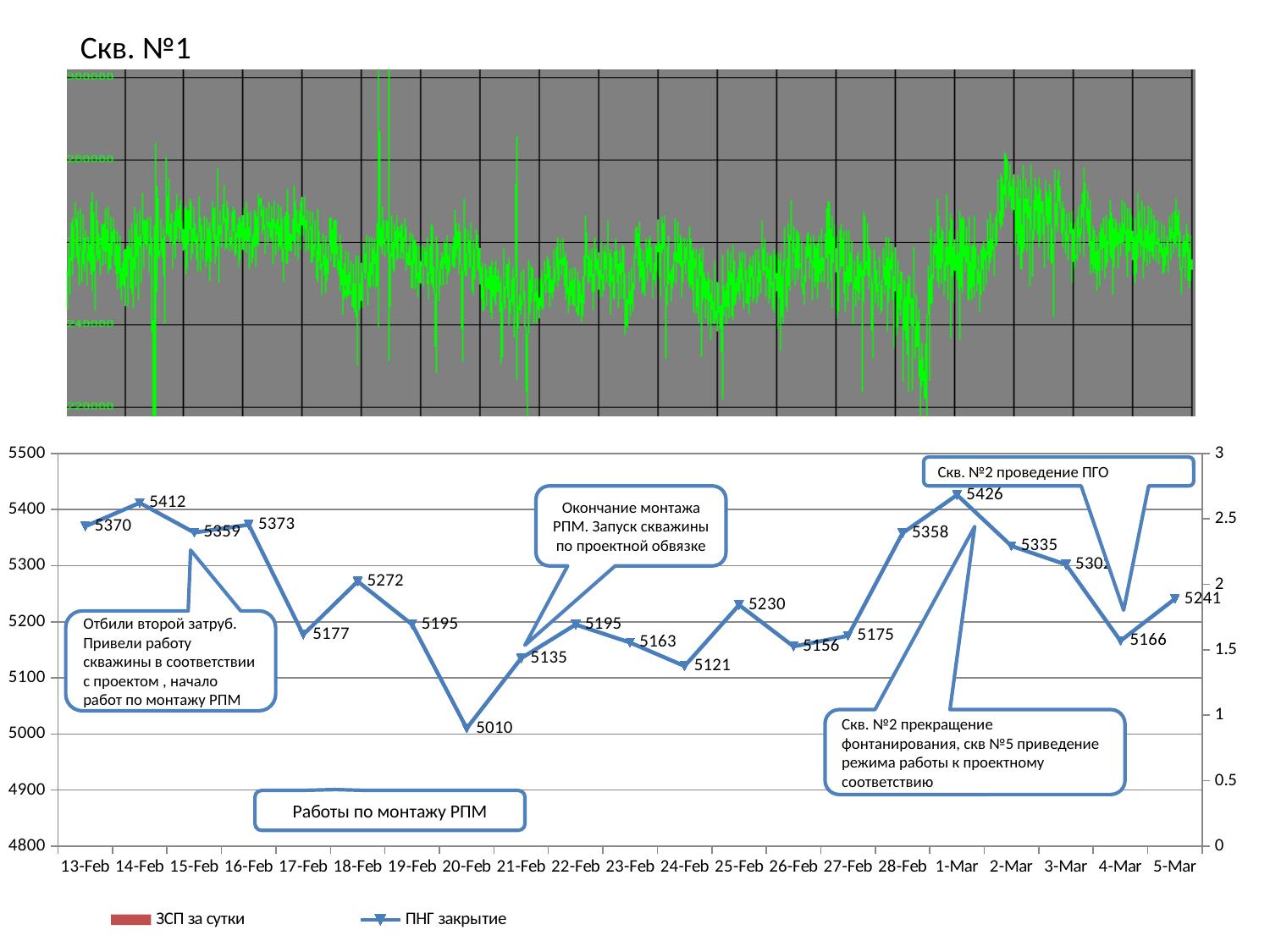
On the bottom line chart, what is the difference between the ПНГ закрытие values on 1-Mar and 20-Feb? 416 On the bottom line chart, what is the ПНГ закрытие value on 20-Feb? 5010 On the bottom line chart, what is the ПНГ закрытие value on 25-Feb? 5230 On the bottom chart, how many series does the legend list? 2 On the bottom line chart, what is the ПНГ закрытие value on 14-Feb? 5412 On the bottom line chart, is the ПНГ закрытие value on 4-Mar greater or less than 5200? less On the bottom line chart, what is the ПНГ закрытие value on 1-Mar? 5426 On the bottom line chart, on which date is the ПНГ закрытие value lowest? 20-Feb On the bottom line chart, how many dates are shown on the x axis? 21 On the bottom line chart, on which date is the ПНГ закрытие value highest? 1-Mar On the bottom line chart, which date has the larger ПНГ закрытие value, 18-Feb or 17-Feb? 18-Feb What type of chart is the bottom chart on the slide? line chart